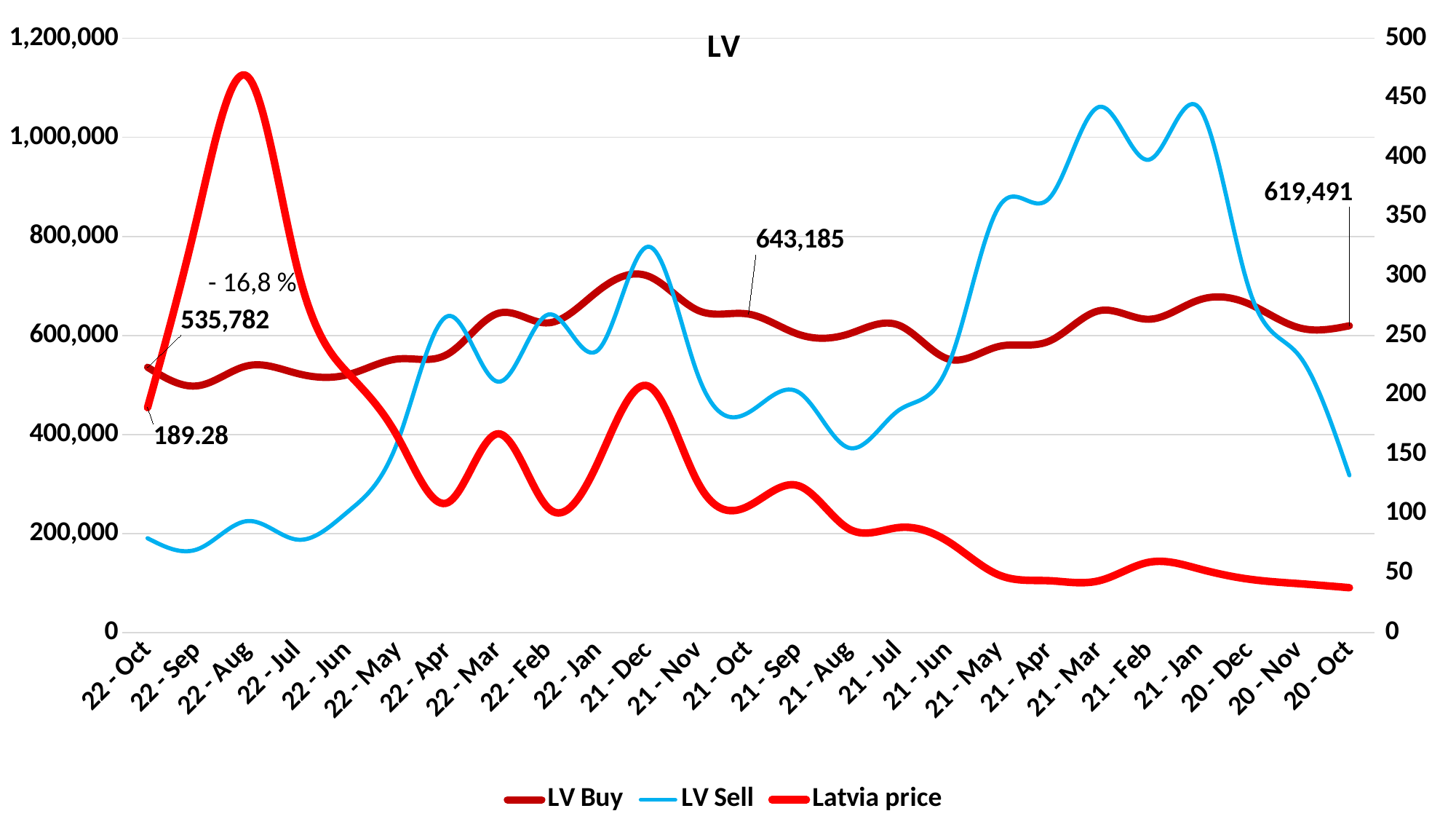
How many months are shown on the x axis? 25 What is the difference between the LV Buy values at 21 - Oct and 20 - Oct? 23,694 What is the LV Buy value at 20 - Oct? 619,491 Which is larger, the LV Buy value at 22 - Oct or at 20 - Oct? 20 - Oct How many series does the legend list? 3 What is the LV Buy value at 22 - Oct? 535,782 What is the LV Buy value at 21 - Oct? 643,185 At which month does the Latvia price reach its highest value? 22 - Aug What is the difference between the LV Buy values at 21 - Oct and 22 - Oct? 107,403 Is the LV Sell value at 21 - Jan greater or less than 1,000,000? greater What is the Latvia price value at 22 - Oct? 189.28 What kind of chart is shown on the slide? line chart